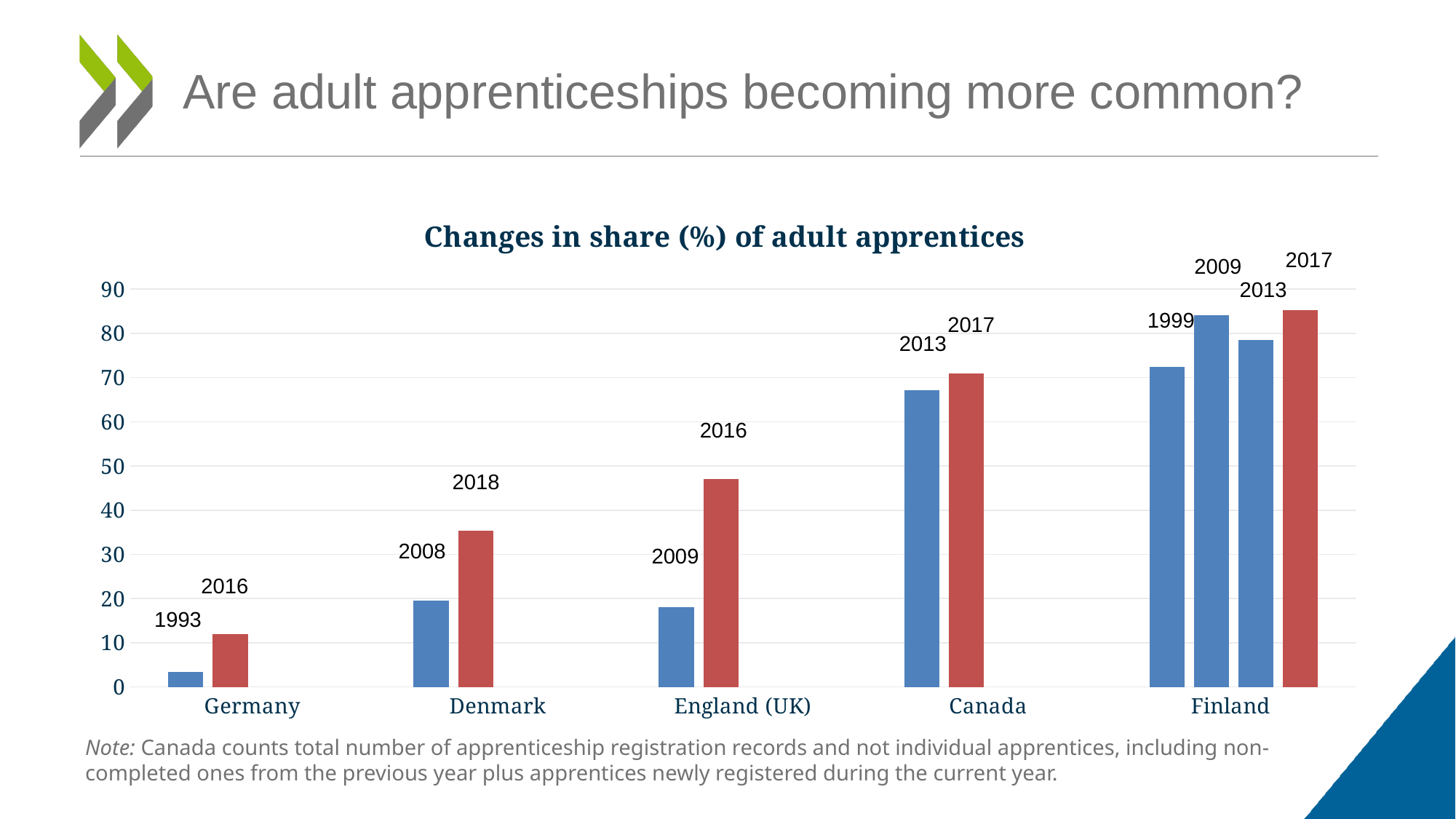
How many bars are plotted for Finland? 4 Is the value for Canada in 2013 greater or less than 60? greater Which country has the most bars in the chart? Finland Is the value for Germany in 2016 greater or less than 20? less Which is larger: the value for Germany in 2016 or the value for Denmark in 2008? Denmark in 2008 Which bar in the chart is the lowest? Germany 1993 What kind of chart is shown on the slide? bar chart Which is larger: the value for Denmark in 2018 or the value for England (UK) in 2016? England (UK) in 2016 How many countries are shown on the x axis of the chart? 5 What is the title of the chart? Changes in share (%) of adult apprentices Is the value for England (UK) in 2016 greater or less than 40? greater